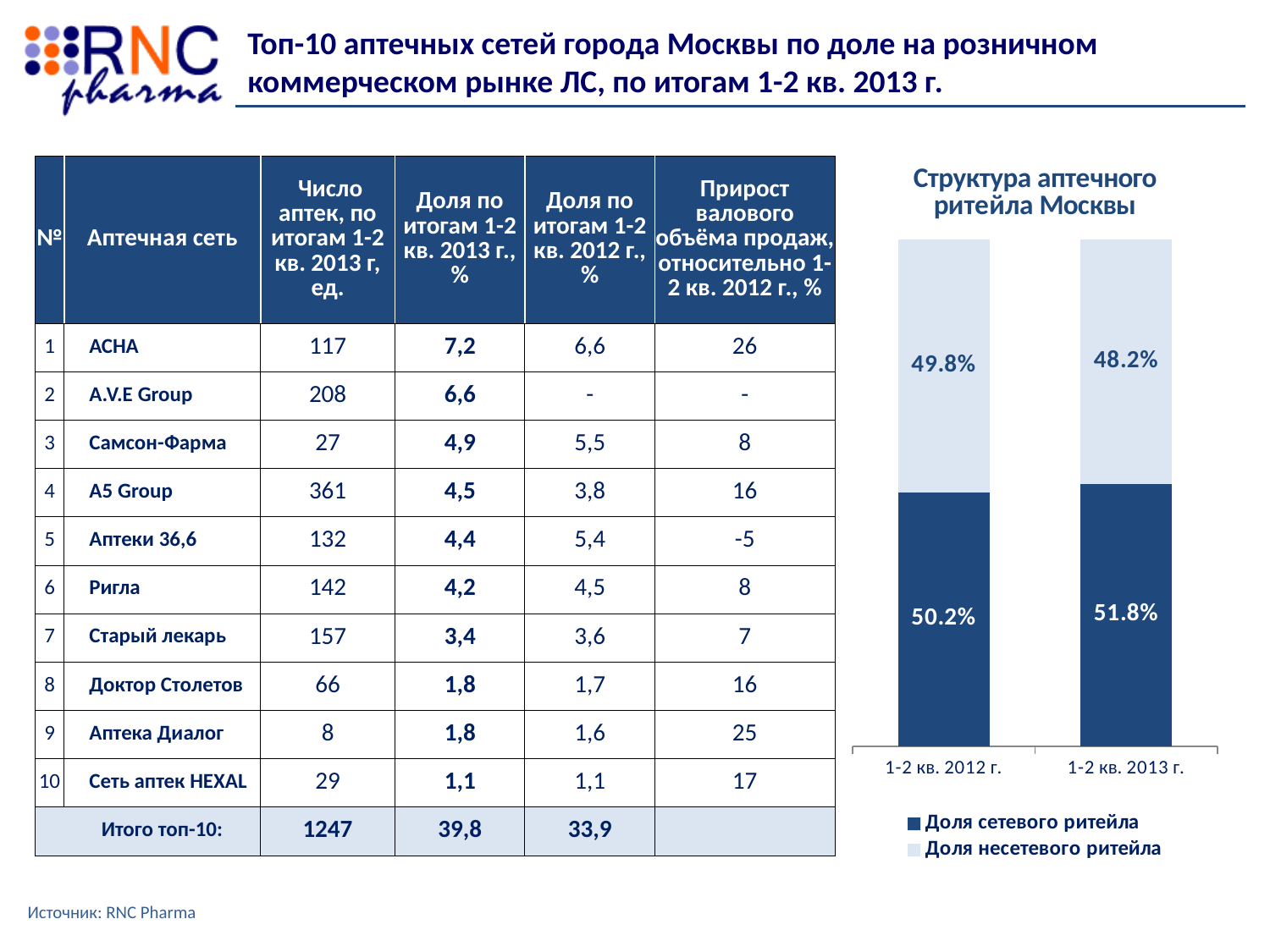
Which series is shown in dark blue in the chart? Доля сетевого ритейла By how much did Доля сетевого ритейла change from 1-2 кв. 2012 г. to 1-2 кв. 2013 г.? 1.6% How many categories are shown on the x axis of the chart? 2 How many series does the chart legend list? 2 What is the value of Доля несетевого ритейла for 1-2 кв. 2013 г.? 48.2% What is the title of the chart on the slide? Структура аптечного ритейла Москвы What is the value of Доля несетевого ритейла for 1-2 кв. 2012 г.? 49.8% Which is larger in 1-2 кв. 2013 г.: Доля сетевого ритейла or Доля несетевого ритейла? Доля сетевого ритейла Does Доля сетевого ритейла rise or fall from 1-2 кв. 2012 г. to 1-2 кв. 2013 г.? rise What is the value of Доля сетевого ритейла for 1-2 кв. 2012 г.? 50.2% What is the value of Доля сетевого ритейла for 1-2 кв. 2013 г.? 51.8% What kind of chart is shown on the right side of the slide? stacked bar chart